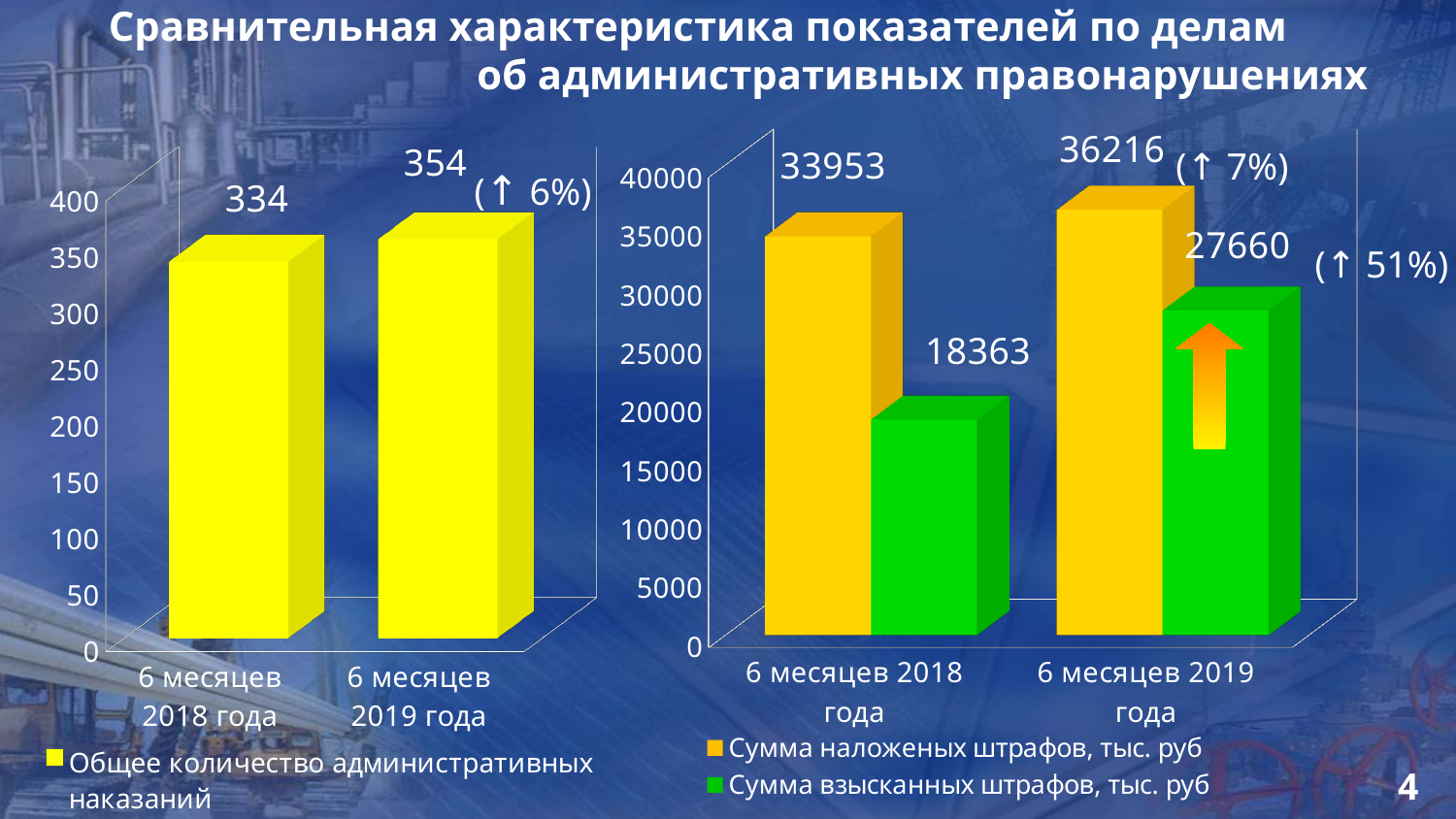
On the right chart, what is the value of Сумма взысканных штрафов, тыс. руб for 6 месяцев 2019 года? 27660 On the right chart, is the value of Сумма взысканных штрафов for 6 месяцев 2018 года greater or less than 20000? less On the right chart, what is the difference between Сумма взысканных штрафов for 6 месяцев 2019 года and 6 месяцев 2018 года? 9297 What kind of chart is the left chart? bar chart On the left chart, do the values rise or fall from 2018 to 2019? rise On the right chart, what is the value of Сумма взысканных штрафов, тыс. руб for 6 месяцев 2018 года? 18363 On the right chart, what is the value of Сумма наложеных штрафов, тыс. руб for 6 месяцев 2018 года? 33953 On the left chart, what is the value for 6 месяцев 2018 года? 334 On the right chart, how many series does the legend list? 2 On the left chart, what is the value for 6 месяцев 2019 года? 354 On the left chart, what is the difference between the values for 6 месяцев 2019 года and 6 месяцев 2018 года? 20 On the right chart, which is larger for 6 месяцев 2019 года: Сумма наложеных штрафов or Сумма взысканных штрафов? Сумма наложеных штрафов